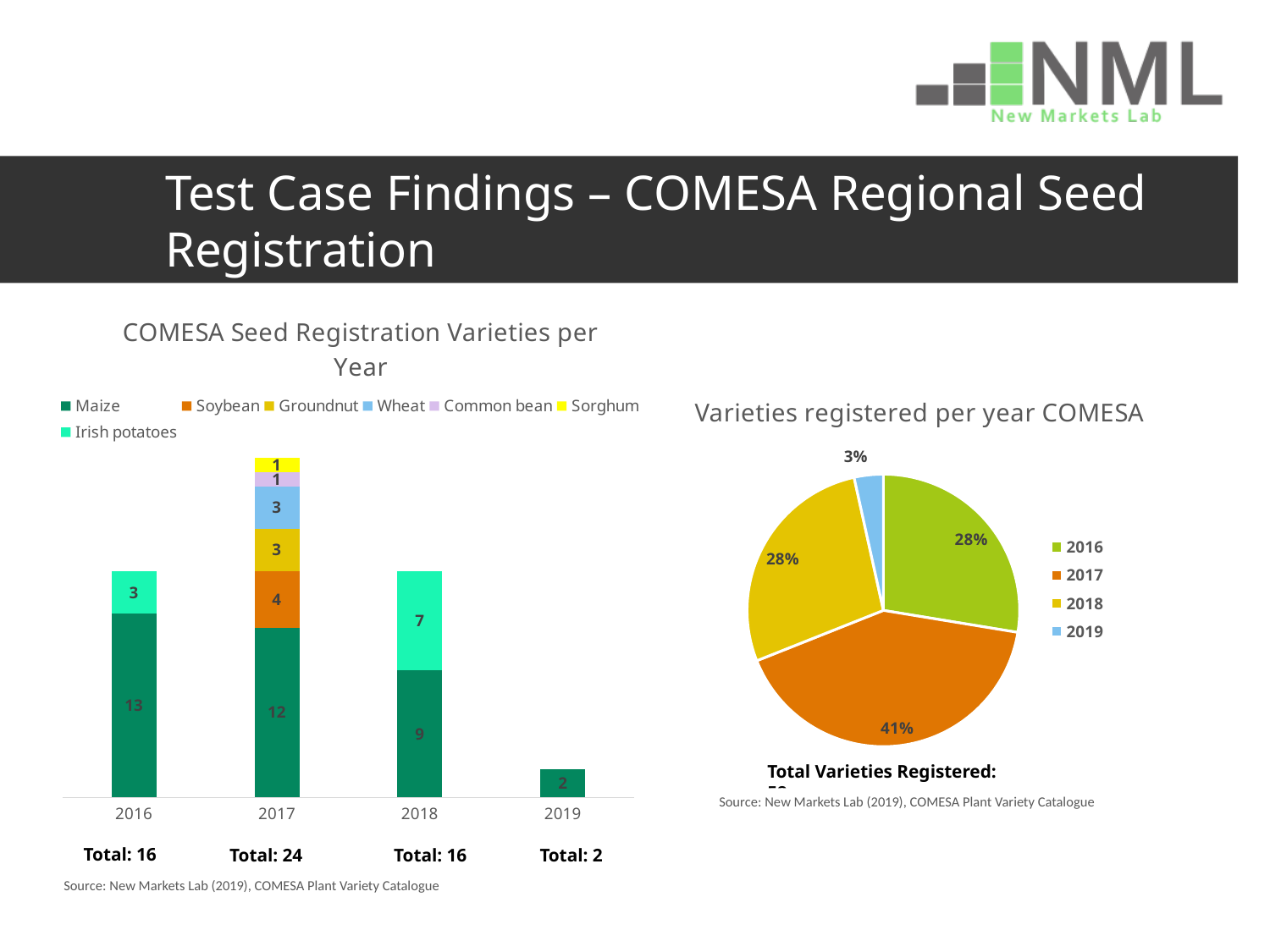
In the 'COMESA Seed Registration Varieties per Year' chart, what is the difference between the Maize values for 2016 and 2018? 4 In the 'Varieties registered per year COMESA' pie chart, what share does 2017 have? 41% How many categories does the 'Varieties registered per year COMESA' pie chart show? 4 In the 'COMESA Seed Registration Varieties per Year' chart, what is the total of the stacked bar for 2017? 24 In the 'Varieties registered per year COMESA' pie chart, is the slice for 2017 larger or smaller than the slice for 2016? Larger In the 'COMESA Seed Registration Varieties per Year' chart, which year has the lowest total? 2019 In the 'COMESA Seed Registration Varieties per Year' chart, what is the value for Maize in 2016? 13 How many series does the legend of the 'COMESA Seed Registration Varieties per Year' chart list? 7 In the 'Varieties registered per year COMESA' pie chart, which year has the smallest slice? 2019 In the 'COMESA Seed Registration Varieties per Year' chart, what is the value for Irish potatoes in 2018? 7 In the 'COMESA Seed Registration Varieties per Year' chart, what is the value for Soybean in 2017? 4 What kind of chart is 'COMESA Seed Registration Varieties per Year'? Stacked bar chart